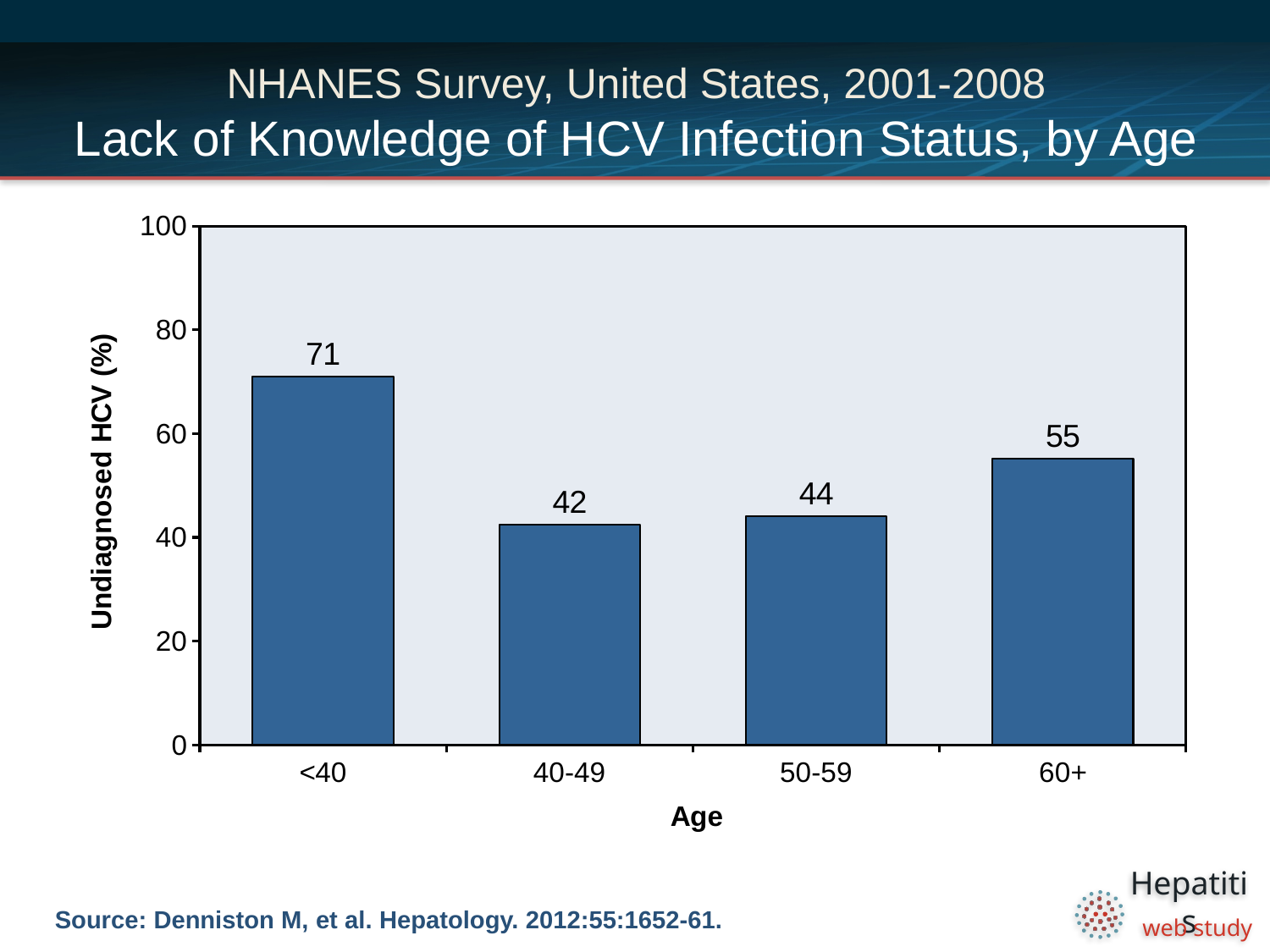
Which age group has a higher percentage of undiagnosed HCV, 50-59 or 60+? 60+ Which age group has the lowest percentage of undiagnosed HCV? 40-49 What kind of chart is shown on the slide? Bar chart What is the percentage of undiagnosed HCV for the <40 age group? 71 What is the percentage of undiagnosed HCV for the 60+ age group? 55 What is the difference in undiagnosed HCV percentage between the <40 and 60+ age groups? 16 Is the value for the 60+ age group greater or less than 60? less What is the difference in undiagnosed HCV percentage between the 50-59 and 40-49 age groups? 2 Which age group has the highest percentage of undiagnosed HCV? <40 How many age groups are shown on the chart? 4 What is the percentage of undiagnosed HCV for the 40-49 age group? 42 What is the label of the y-axis on the chart? Undiagnosed HCV (%)